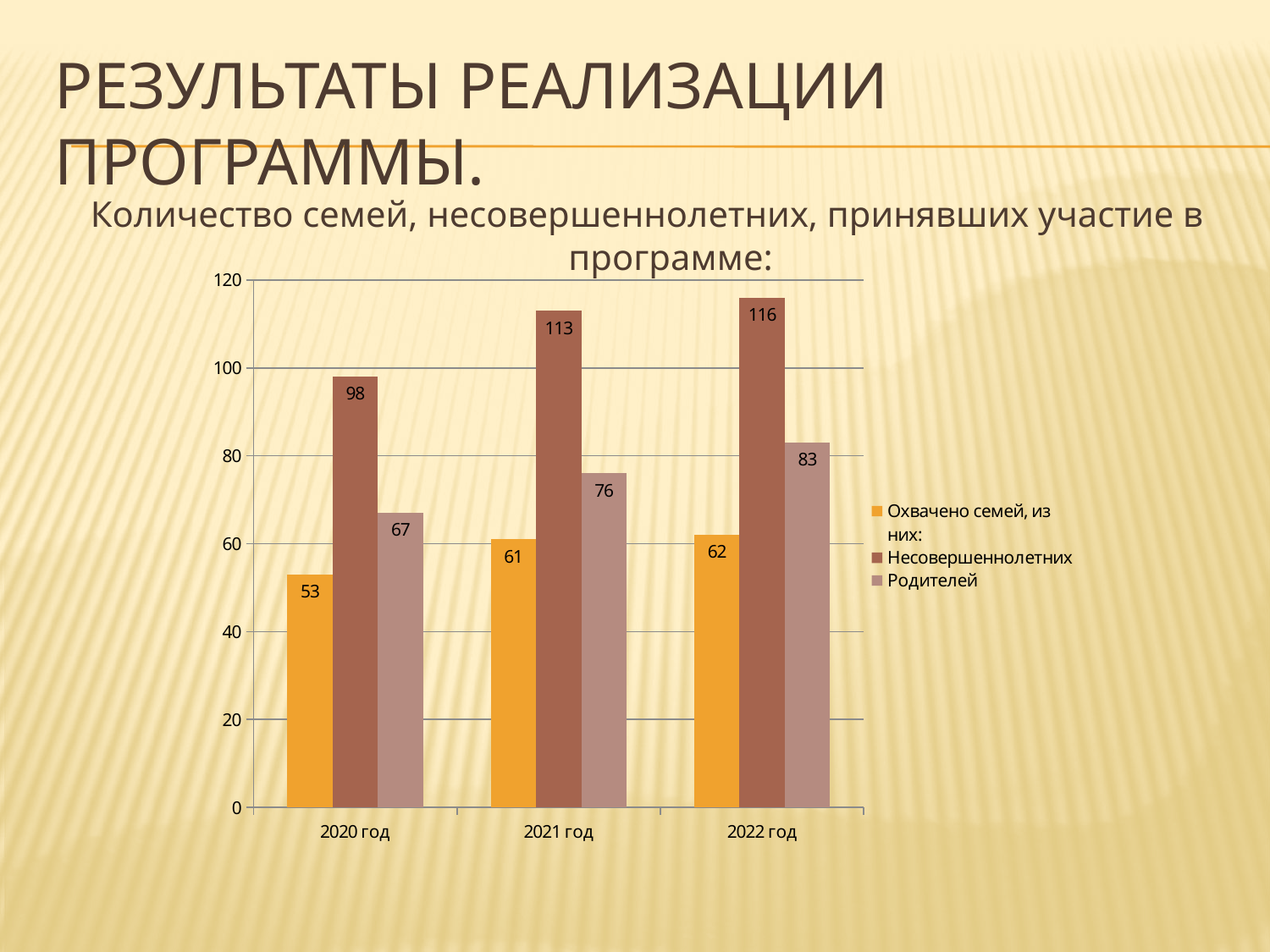
What is the value for Несовершеннолетних in 2021 год? 113 Which is larger: Родителей in 2021 год or Родителей in 2022 год? Родителей in 2022 год What kind of chart is shown on the slide? bar chart How many series does the legend list? 3 Do the values for Родителей rise or fall from 2020 год to 2022 год? rise In which year is the value for Охвачено семей, из них: lowest? 2020 год How many years are shown on the x axis? 3 What is the value for Родителей in 2020 год? 67 What is the difference between the Несовершеннолетних values for 2022 год and 2020 год? 18 What is the value for Охвачено семей, из них: in 2022 год? 62 Is the value for Несовершеннолетних in 2020 год greater or less than 100? less In which year is the value for Несовершеннолетних highest? 2022 год